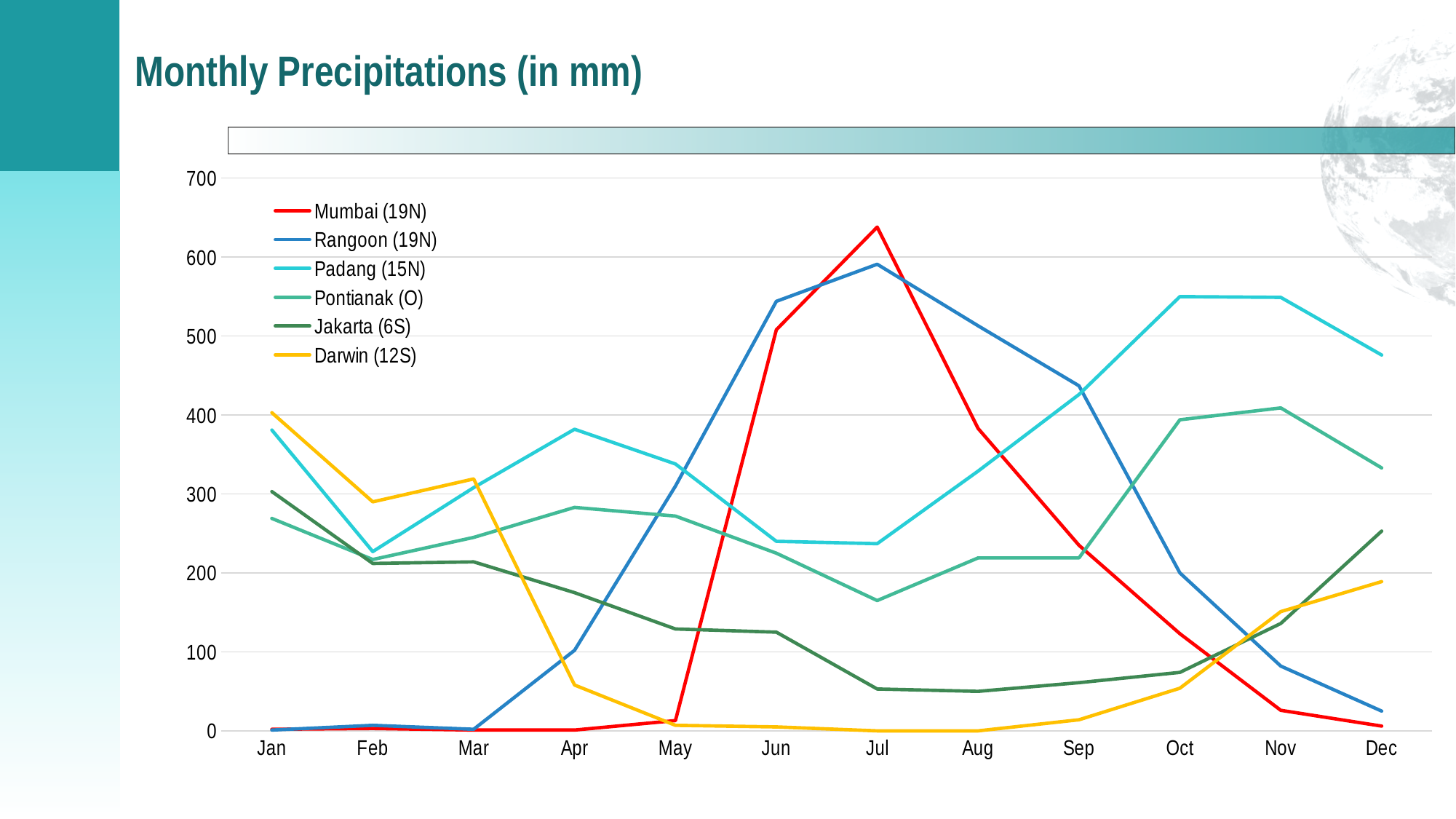
Is the value for Padang (15N) in Nov greater or less than 500? greater In which month does Mumbai (19N) reach its highest precipitation? Jul What is the title of the chart? Monthly Precipitations (in mm) What kind of chart is shown on the slide? line chart How many series does the legend list? 6 In Oct, which is larger, the value for Padang (15N) or for Pontianak (O)? Padang (15N) Is the value for Darwin (12S) in Jul greater or less than 100? less Which series has the highest value in Jul? Mumbai (19N) Is the value for Mumbai (19N) in Jul greater or less than 600? greater How many months are shown along the x axis? 12 Does the Darwin (12S) line rise or fall from Jan to Apr? fall Which series has the highest value in Jan? Darwin (12S)